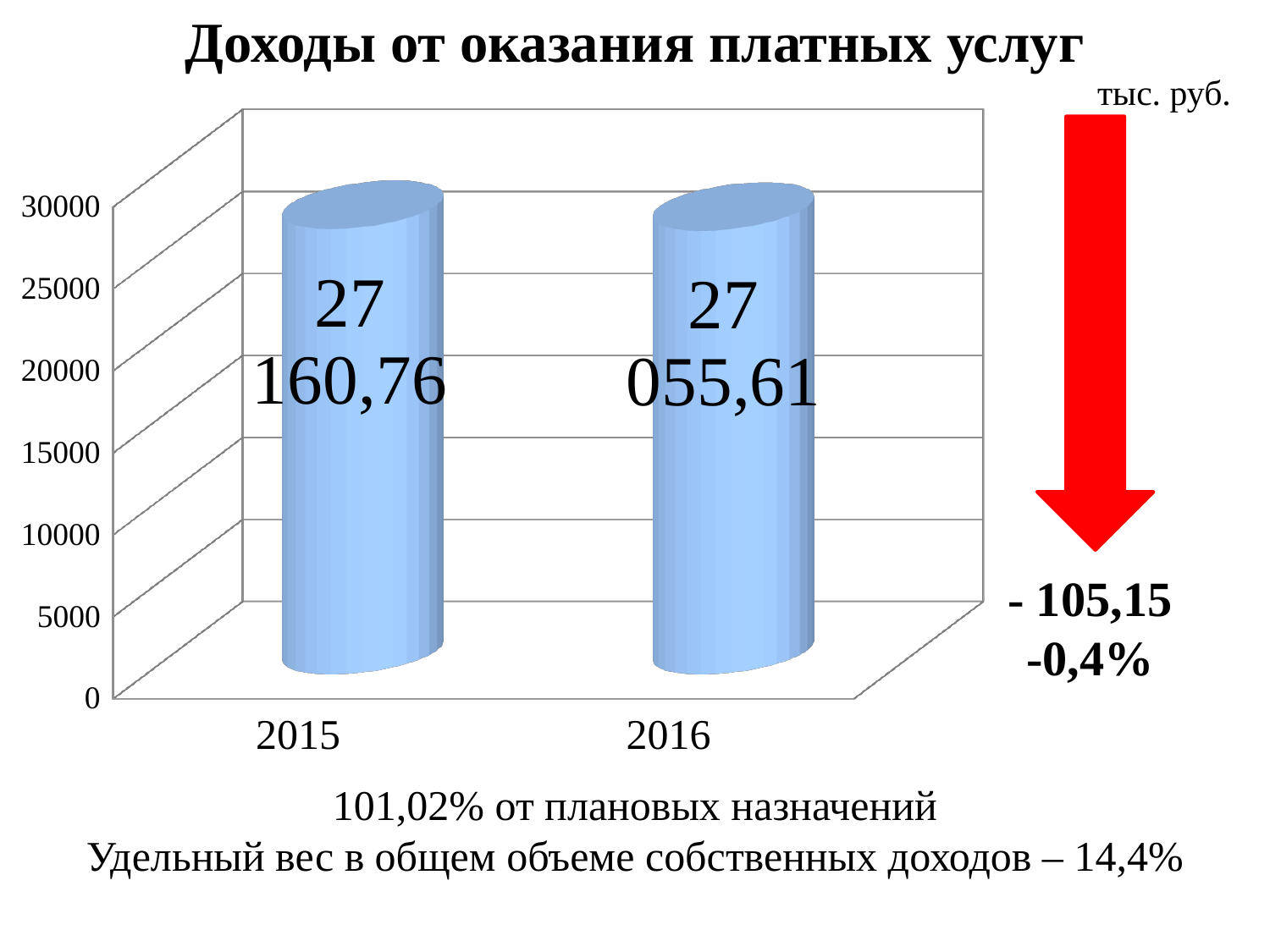
What is the value for 2016? 27 055,61 What is the title of the chart? Доходы от оказания платных услуг What is the difference between the 2015 and 2016 values? 105,15 Is the value for 2016 greater or less than 25000? greater Do the values rise or fall from 2015 to 2016? fall Is the value for 2015 larger or smaller than the value for 2016? larger Which year has the higher value? 2015 What kind of chart is shown on the slide? bar chart Is the value for 2015 greater or less than 30000? less Which year has the lower value? 2016 What is the value for 2015? 27 160,76 How many years are shown on the chart? 2